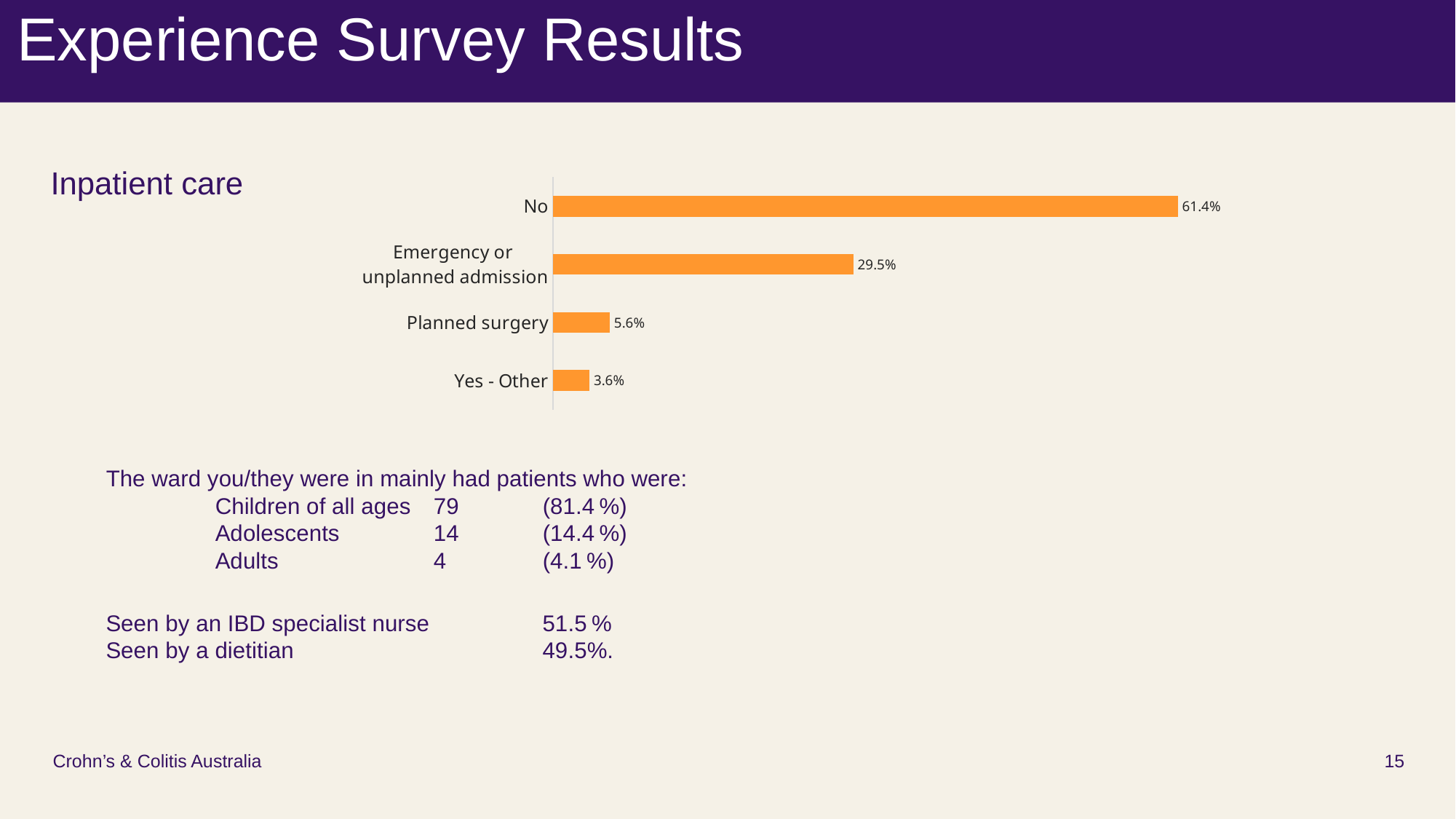
How many categories are shown in the chart? 4 What colour are the bars in the chart? Orange What is the value for "Emergency or unplanned admission"? 29.5% What is the difference between the values for "No" and "Emergency or unplanned admission"? 31.9% What is the value for "Yes - Other"? 3.6% What is the value for "Planned surgery"? 5.6% What is the value for "No" in the inpatient care chart? 61.4% Which category has the lowest value in the chart? Yes - Other What kind of chart is shown on the slide? Bar chart Which category has the highest value in the chart? No What is the difference between the values for "Planned surgery" and "Yes - Other"? 2.0% Which is larger, the value for "Planned surgery" or the value for "Yes - Other"? Planned surgery